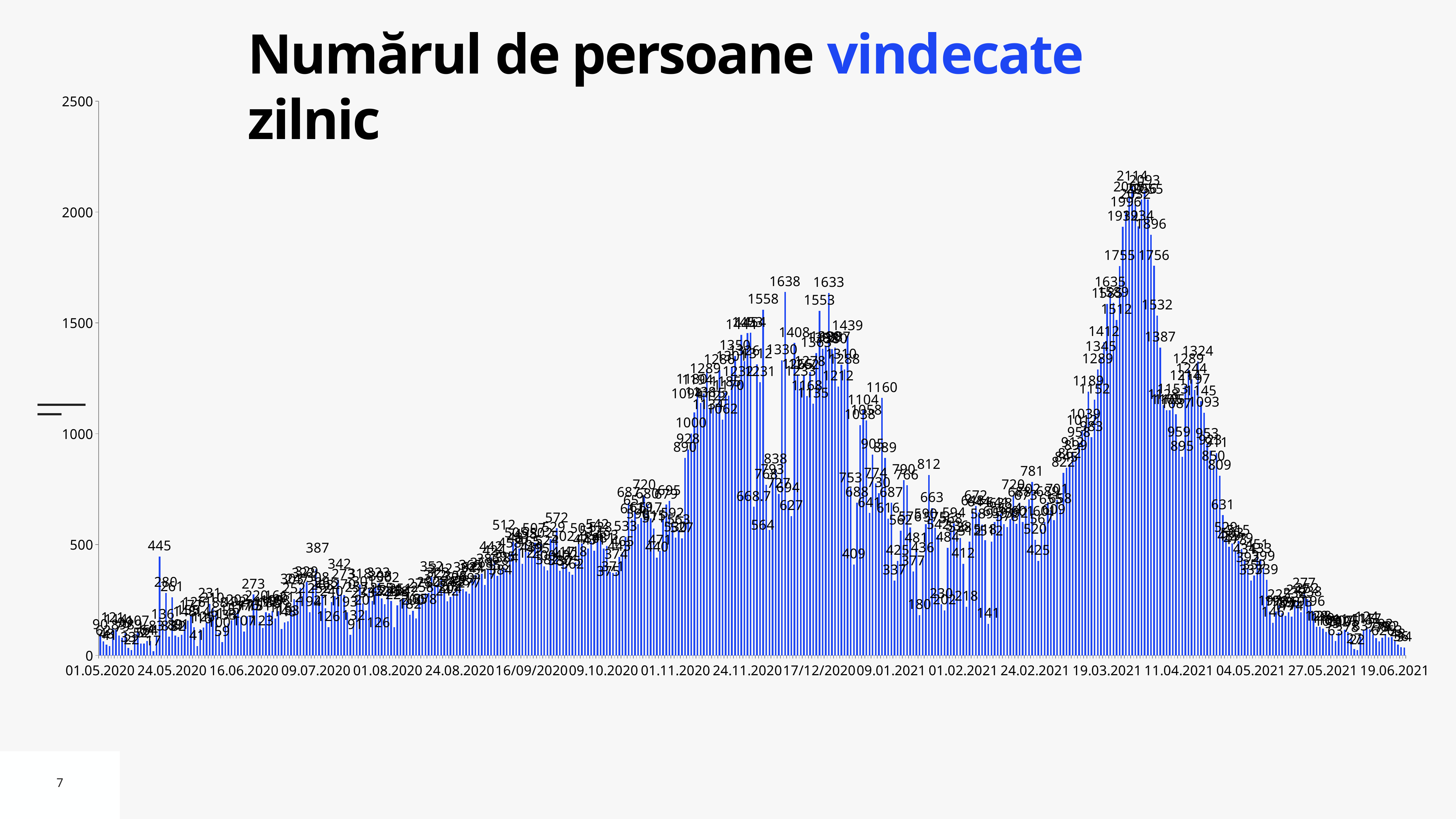
Which peak is higher: the one around 11.04.2021 or the one around 17/12/2020? the one around 11.04.2021 What is the title of the chart? Numărul de persoane vindecate zilnic What is the highest value labeled on the chart? 2114 What is the value of the tallest bar in early July 2020? 387 What is the value of the tallest bar in May 2020? 445 What is the highest value shown on the vertical axis? 2500 Do the values generally rise or fall from 01.05.2020 to 24.11.2020? rise Do the values generally rise or fall from 11.04.2021 to 19.06.2021? fall What kind of chart is shown on the slide? bar chart What is the difference between the two tallest labeled values of the December 2020 peak, 1638 and 1633? 5 Is the tallest bar on the chart greater or less than 2000? greater Are the bars around 19.06.2021 greater or less than 500? less